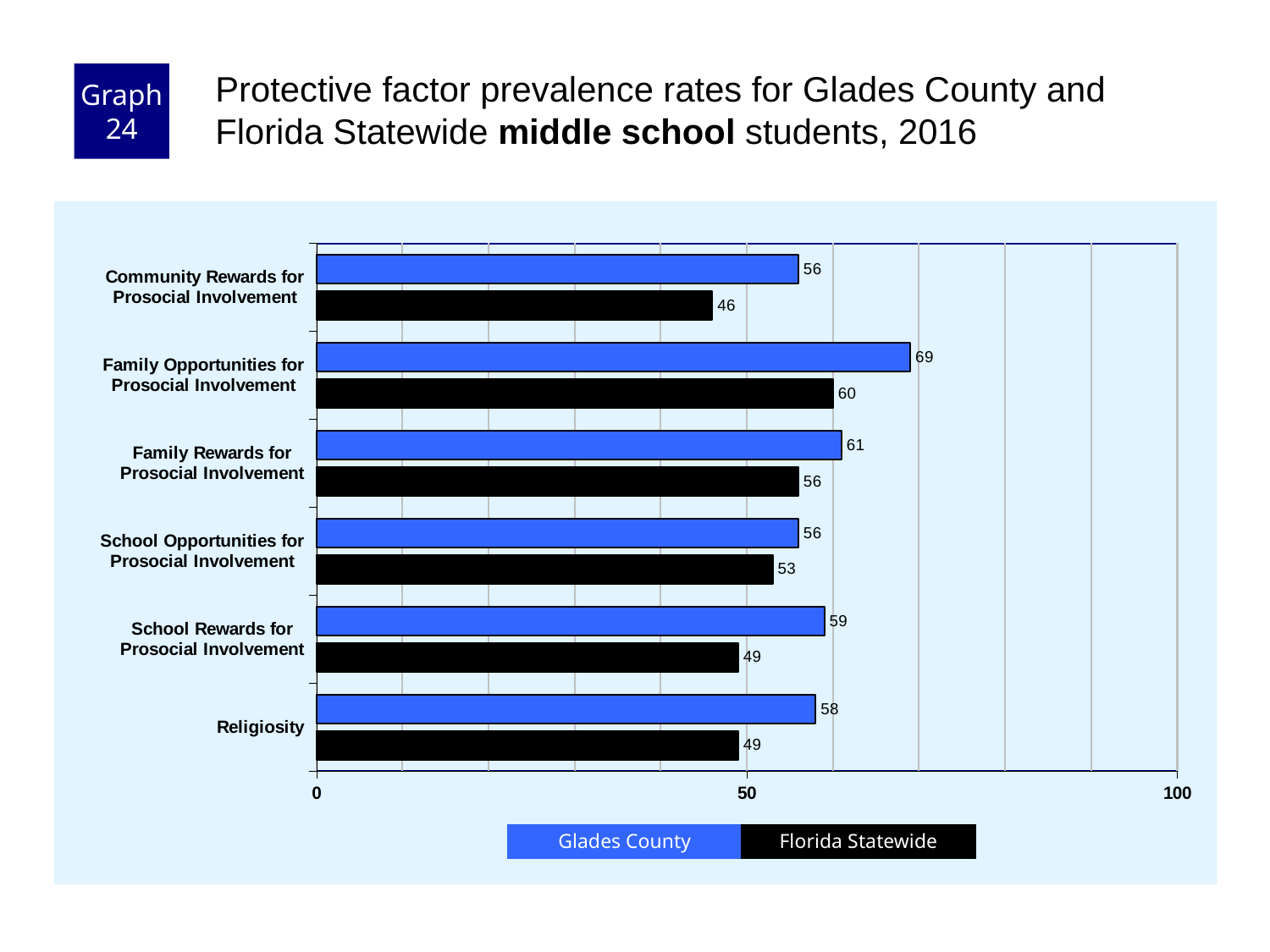
What is the Florida Statewide value for Religiosity? 49 What is the Florida Statewide value for Community Rewards for Prosocial Involvement? 46 What kind of chart is shown on the slide? bar chart What is the difference between the Glades County and Florida Statewide values for School Rewards for Prosocial Involvement? 10 Which is larger for Family Rewards for Prosocial Involvement: the Glades County value or the Florida Statewide value? Glades County Which category has the highest Glades County value? Family Opportunities for Prosocial Involvement What is the Glades County value for Family Opportunities for Prosocial Involvement? 69 How many categories are shown on the chart? 6 Is the Florida Statewide value for Community Rewards for Prosocial Involvement greater or less than 50? less Which category has the lowest Florida Statewide value? Community Rewards for Prosocial Involvement Which colour represents Florida Statewide in the chart? black How many series does the legend list? 2